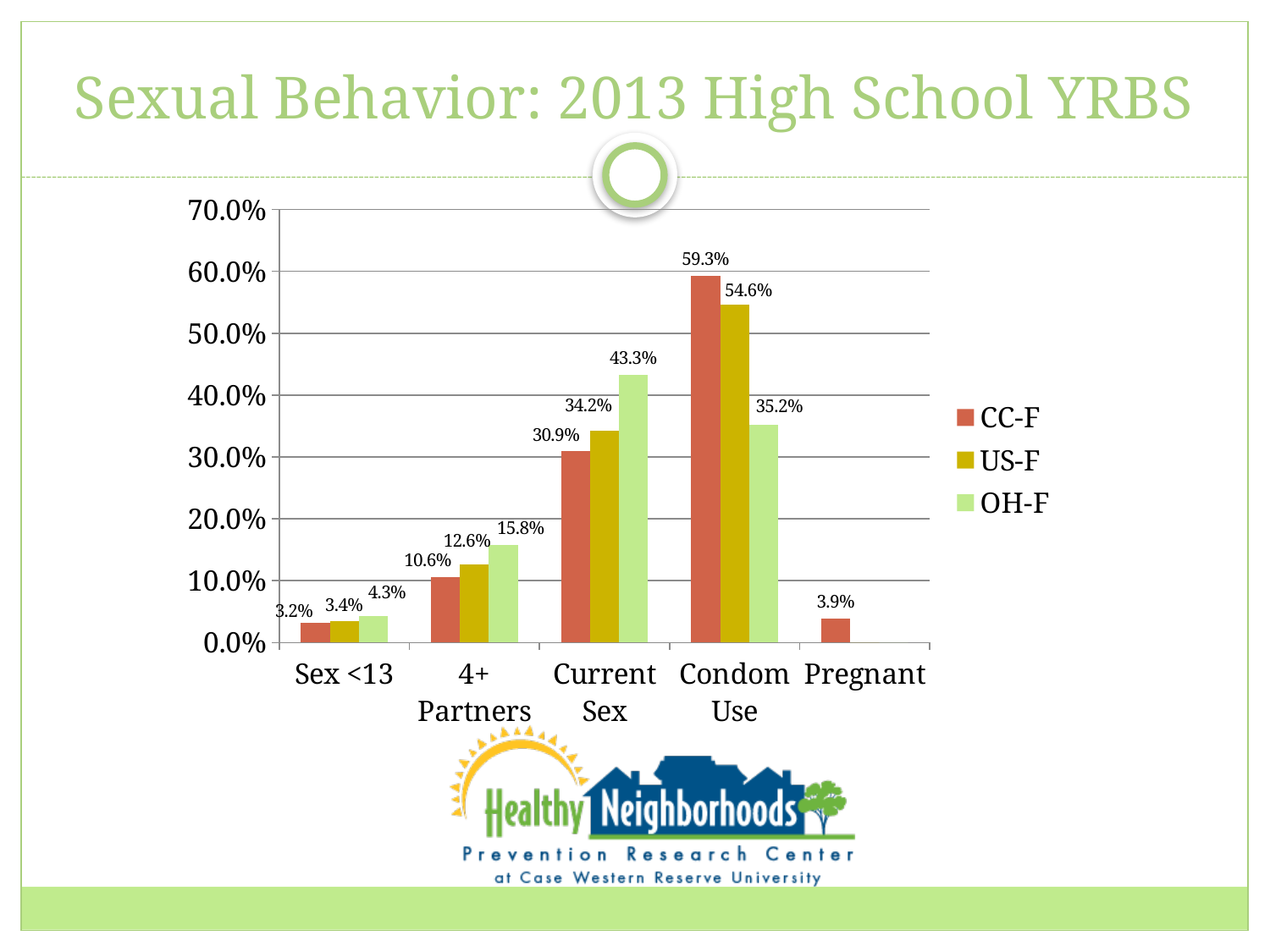
How many series does the legend list? 3 What is the OH-F value for Current Sex? 43.3% What is the title of the slide? Sexual Behavior: 2013 High School YRBS How many categories are shown on the x axis? 5 What is the CC-F value for Pregnant? 3.9% Which is larger for Current Sex, the CC-F value or the US-F value? US-F What is the CC-F value for Condom Use? 59.3% Which category has the highest CC-F value? Condom Use What is the difference between the CC-F and US-F values for Condom Use? 4.7% What kind of chart is shown on the slide? Bar chart What is the US-F value for 4+ Partners? 12.6%